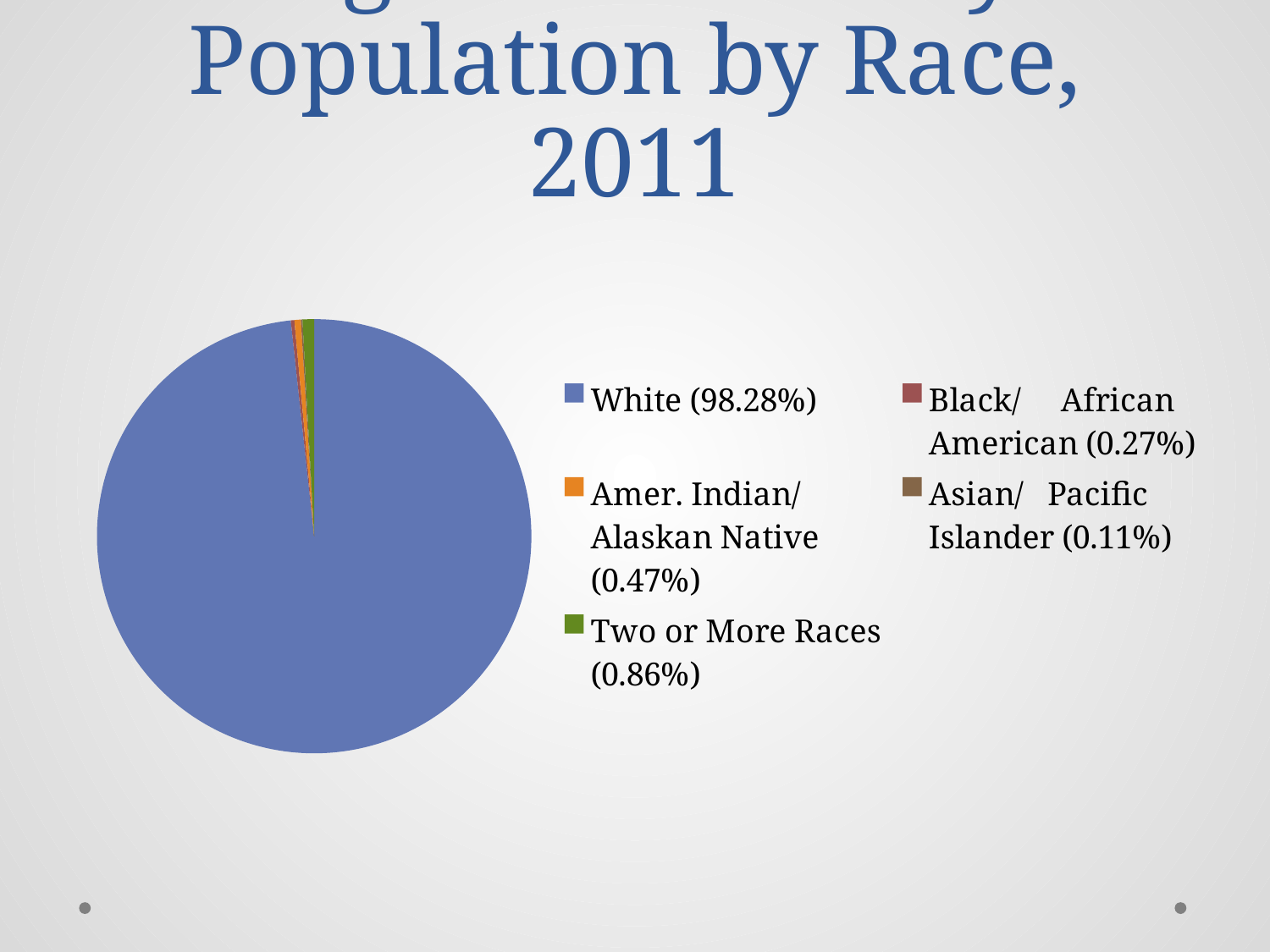
What share of the population is White according to the legend? 98.28% Which race category has the smallest share of the pie? Asian/Pacific Islander Which race category has the largest share of the pie? White What percentage is shown for Asian/Pacific Islander? 0.11% What colour is the slice representing White in the pie chart? blue What percentage is shown for Black/African American? 0.27% Which is larger, the share for Two or More Races or the share for Amer. Indian/Alaskan Native? Two or More Races What percentage is shown for Amer. Indian/Alaskan Native? 0.47% What kind of chart is shown on the slide? pie chart What percentage is shown for Two or More Races? 0.86% How many categories does the pie chart have? 5 What is the difference in percentage points between Two or More Races (0.86%) and Black/African American (0.27%)? 0.59%